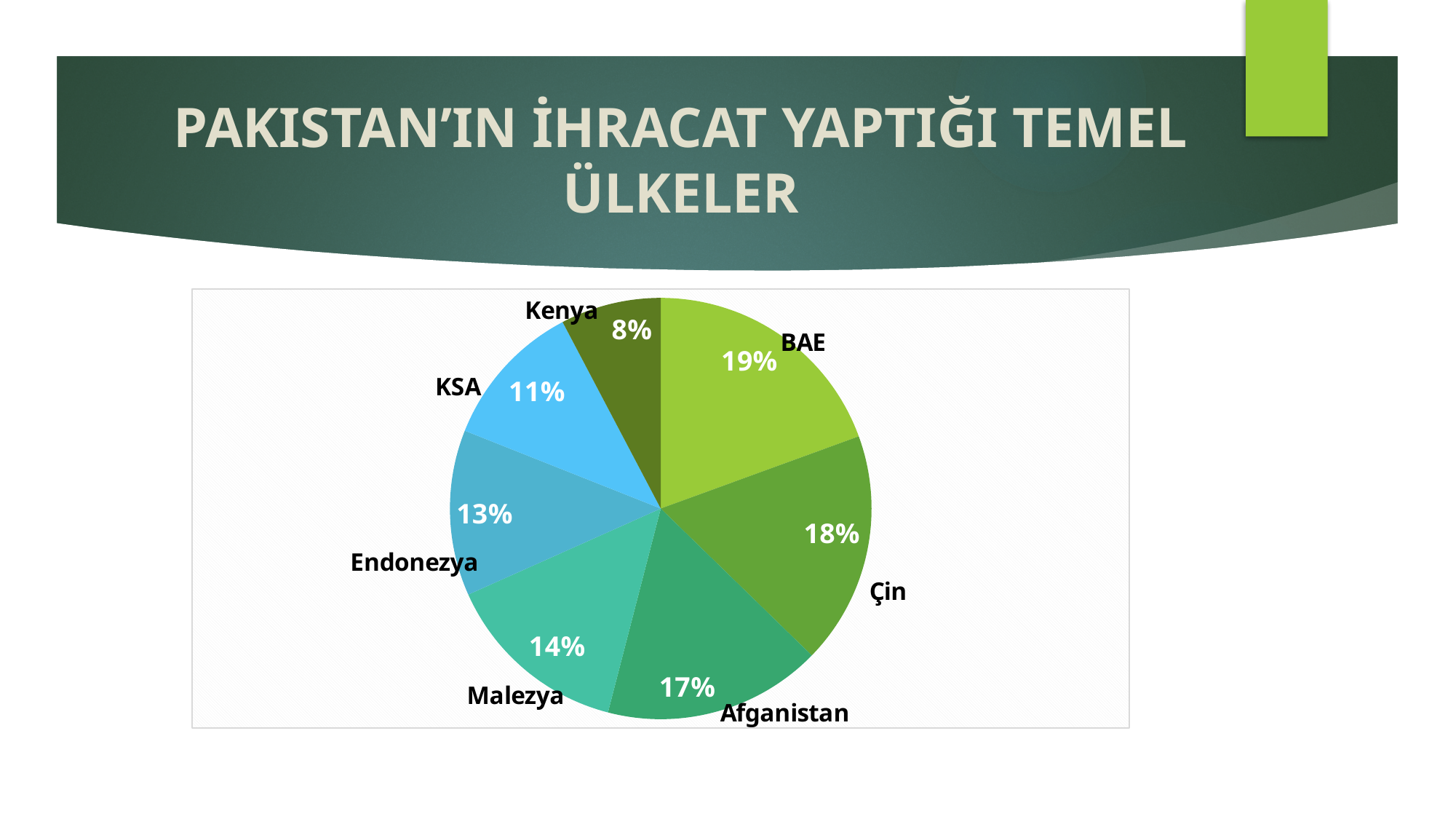
What share of the pie does BAE have? 19% Which country has the smallest slice of the pie? Kenya What share of the pie does KSA have? 11% How many countries are shown in the pie chart? 7 What share of the pie does Afganistan have? 17% What share of the pie does Malezya have? 14% What is the difference in percentage points between BAE and Kenya? 11 Which has a larger share, Malezya or KSA? Malezya What share of the pie does Endonezya have? 13% What share of the pie does Çin have? 18% What kind of chart is shown on the slide? Pie chart Which country has the largest slice of the pie? BAE